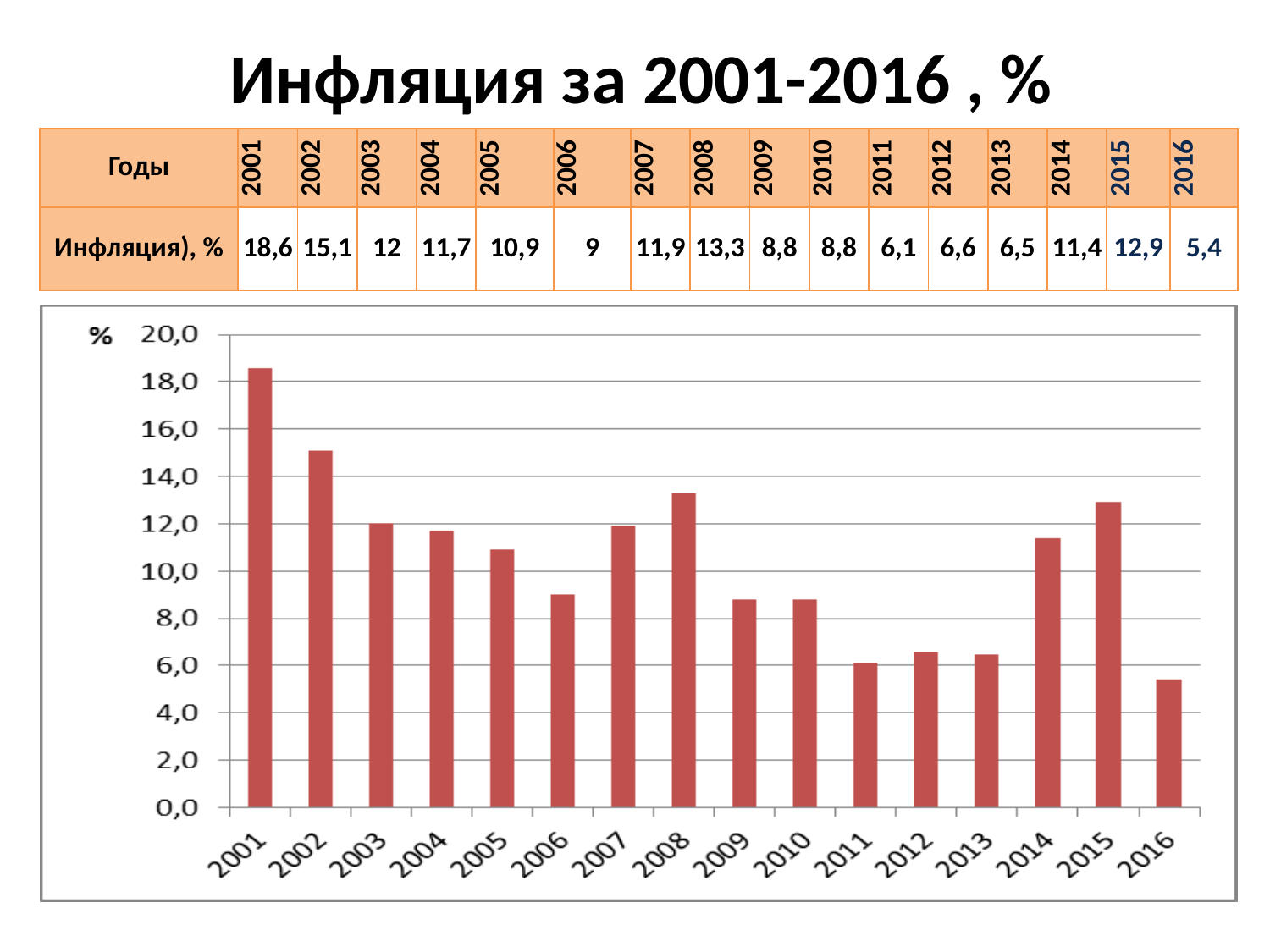
What is the inflation value for 2008? 13,3 What is the inflation value for 2016? 5,4 How many years are shown on the x axis of the chart? 16 Which year has the larger inflation value, 2014 or 2015? 2015 What is the difference between the inflation values for 2001 and 2016? 13,2 Is the value for 2008 greater or less than 12,0? greater What kind of chart is shown on the slide? bar chart What is the difference between the inflation values for 2008 and 2007? 1,4 Which year has the lowest inflation? 2016 Do the inflation values rise or fall from 2001 to 2006? fall Which year has the highest inflation? 2001 What is the inflation value for 2001? 18,6